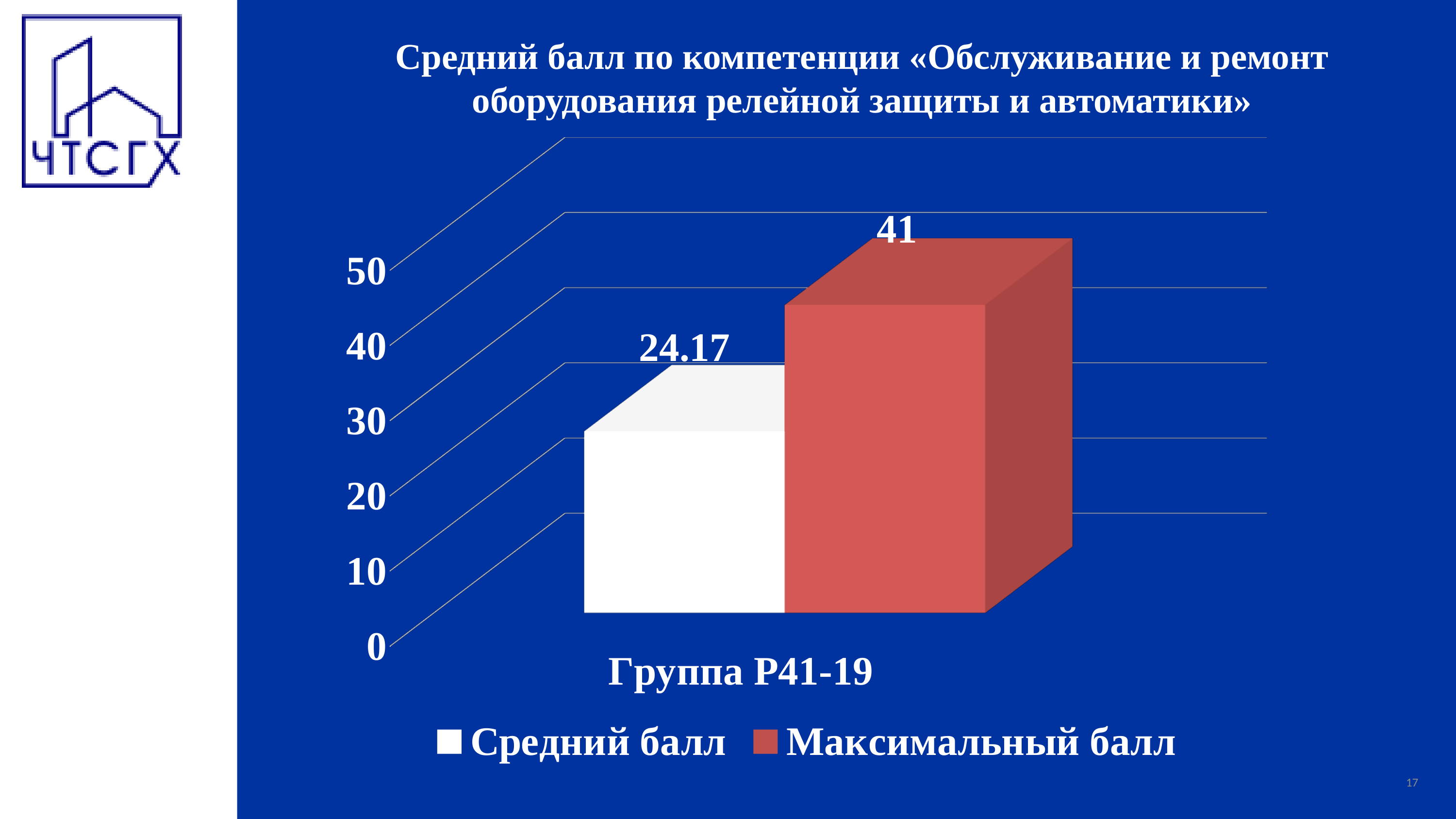
Which series has the higher value for Группа Р41-19, "Средний балл" or "Максимальный балл"? Максимальный балл What is the value of "Максимальный балл" for Группа Р41-19? 41 What is the difference between "Максимальный балл" and "Средний балл" for Группа Р41-19? 16.83 Is the value for "Максимальный балл" greater or less than 40? greater What is the value of "Средний балл" for Группа Р41-19? 24.17 What is the category label on the x axis? Группа Р41-19 How many categories are shown on the x axis? 1 Is the value for "Средний балл" greater or less than 30? less How many series does the legend list? 2 What kind of chart is shown on the slide? bar chart What colour is the bar for "Максимальный балл"? red What is the highest tick value shown on the vertical axis? 50